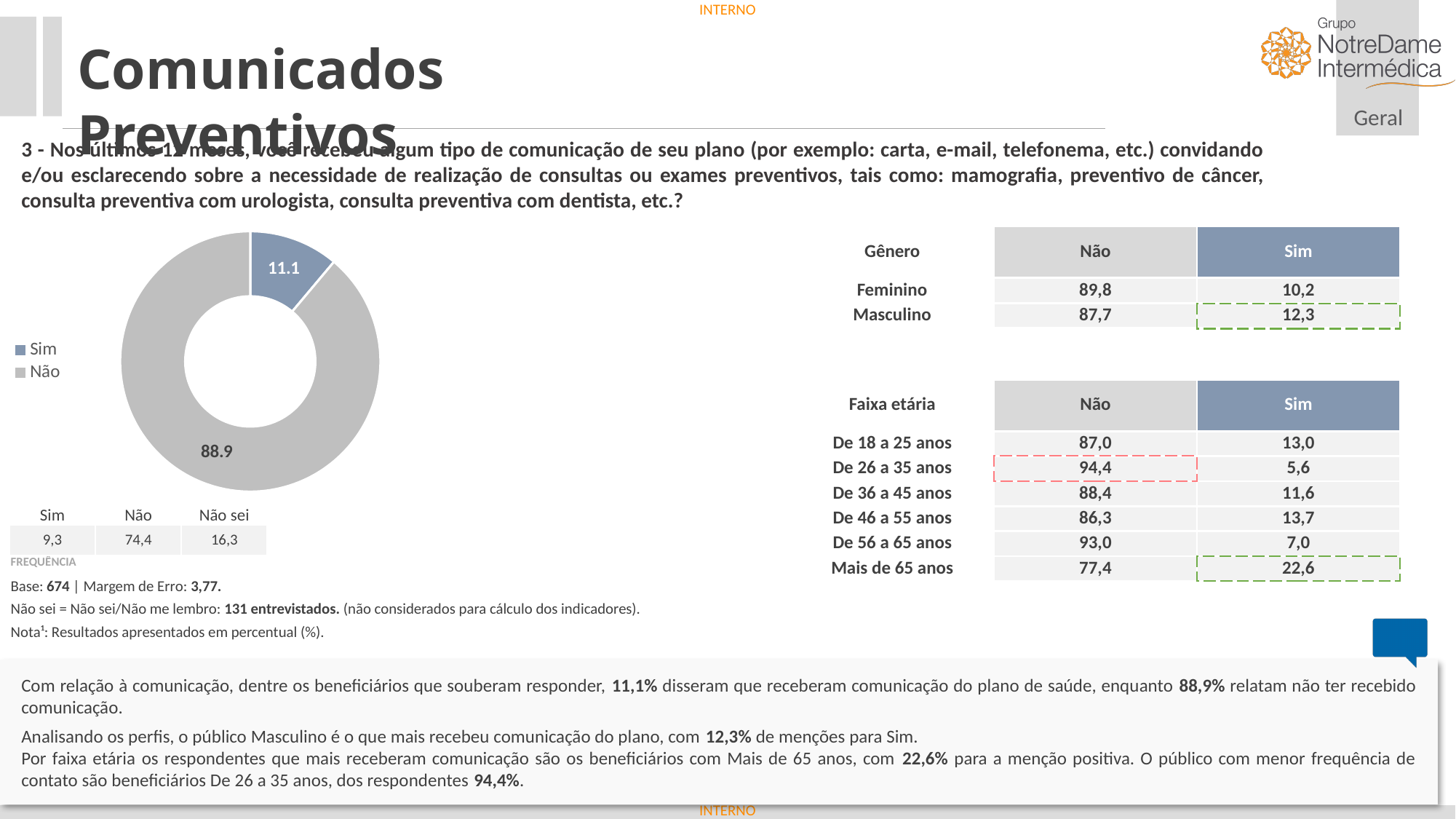
What value is shown for the "Não" slice of the donut chart? 88.9 What share of the donut chart does the "Sim" slice represent? 11.1 What value is shown for the "Sim" slice of the donut chart? 11.1 What kind of chart is shown on the left of the slide? Donut (pie) chart How many slices does the donut chart have? 2 Which legend entry of the donut chart is shown in grey? Não What is the difference between the "Não" and "Sim" values in the donut chart? 77.8 Which colour is used for the "Sim" slice in the donut chart? Blue Which slice of the donut chart is the largest? Não Which slice of the donut chart is the smallest? Sim How many entries does the legend of the donut chart list? 2 In the donut chart, which is larger: "Sim" or "Não"? Não